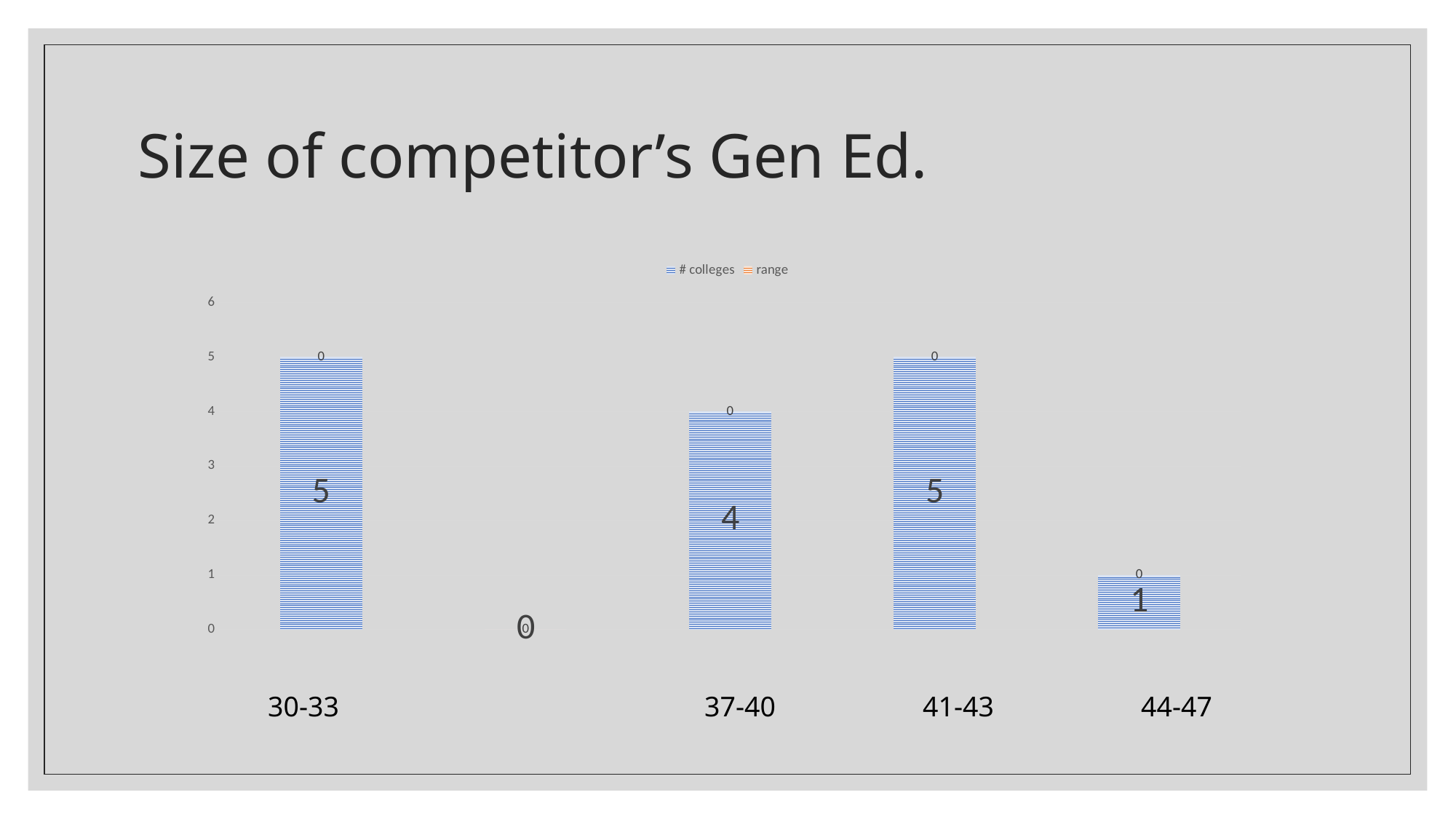
How many series does the legend list? 2 What is the value for the 30-33 category? 5 Is the value for 44-47 greater or less than 2? less What is the difference between the values for 30-33 and 44-47? 4 What is the value for the 41-43 category? 5 Which has the larger value, 30-33 or 37-40? 30-33 What is the value for the 44-47 category? 1 Which has the larger value, 37-40 or 44-47? 37-40 What is the difference between the values for 37-40 and 44-47? 3 What is the value for the 37-40 category? 4 What is the title of the slide? Size of competitor's Gen Ed. What kind of chart is shown on the slide? bar chart